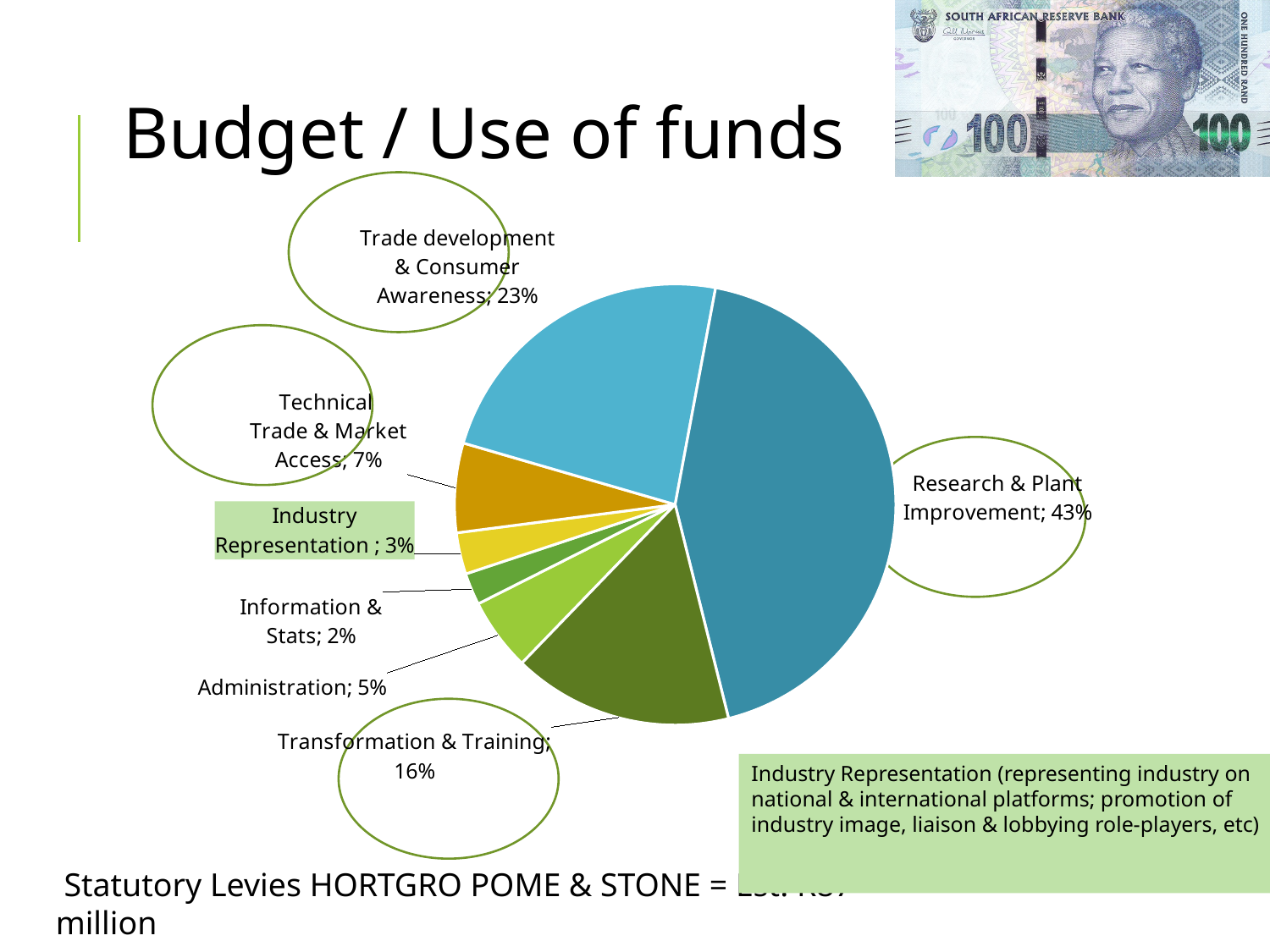
What share of the budget goes to Research & Plant Improvement? 43% What percentage is shown for Industry Representation? 3% What is the difference in percentage points between Research & Plant Improvement and Trade development & Consumer Awareness? 20 What kind of chart is shown on the slide? Pie chart What share is allocated to Administration? 5% Which category has the smallest share of the pie? Information & Stats What percentage is allocated to Trade development & Consumer Awareness? 23% How many categories are shown in the pie chart? 7 What percentage is shown for Technical Trade & Market Access? 7% What share does Transformation & Training receive? 16% Which is larger, the share for Administration or the share for Technical Trade & Market Access? Technical Trade & Market Access Which category has the largest share of the pie? Research & Plant Improvement